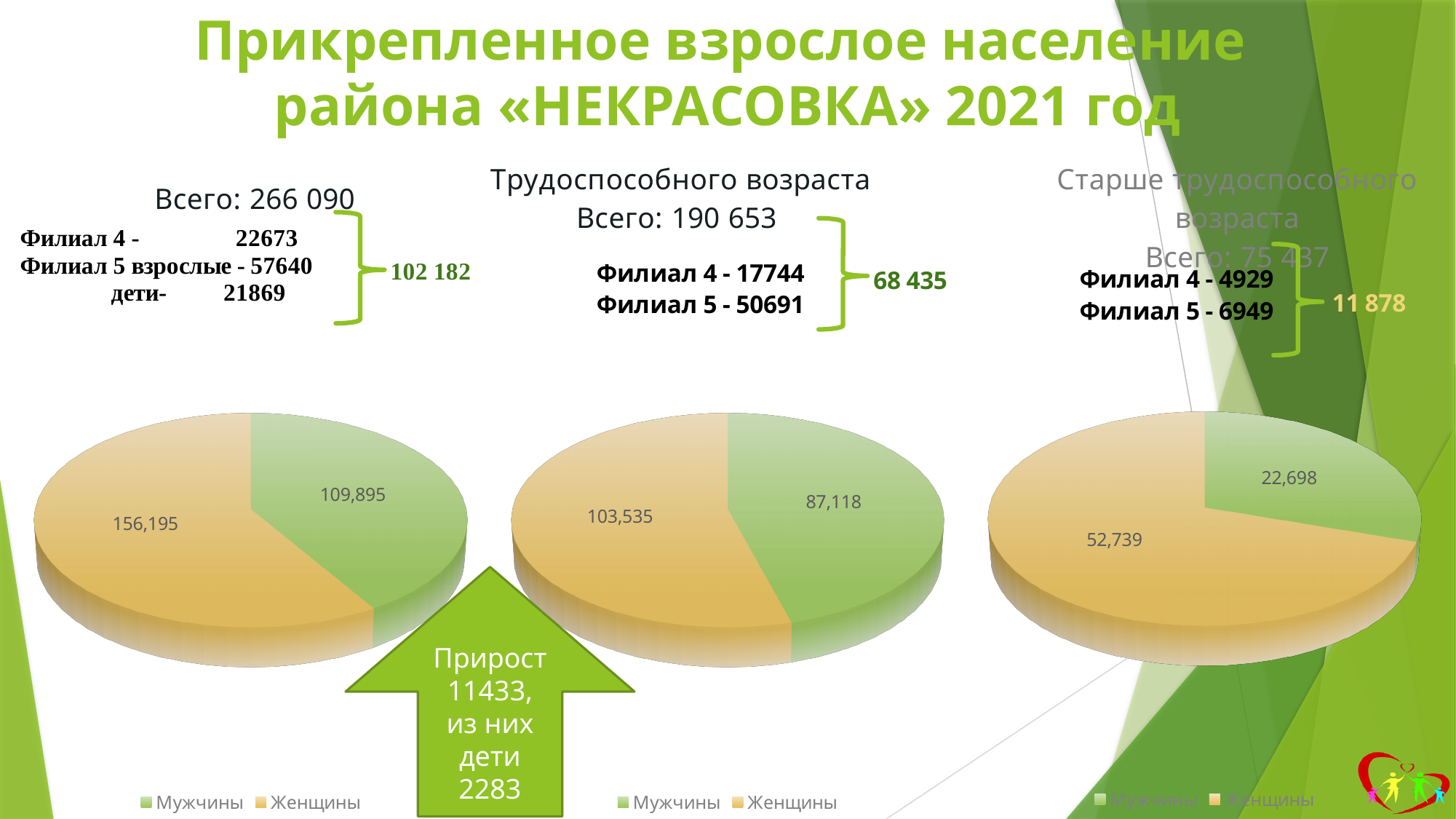
In the right pie chart, what is the value for Женщины? 52,739 In the right pie chart, which slice is larger, Мужчины or Женщины? Женщины In the left pie chart, what is the value for Женщины? 156,195 How many pie charts are shown on the slide? 3 In the middle pie chart, what is the difference between the Женщины and Мужчины values? 16,417 In the right pie chart, what is the value for Мужчины? 22,698 In the middle pie chart, what is the value for Мужчины? 87,118 How many series does the legend of the left pie chart list? 2 In the left pie chart, what is the value for Мужчины? 109,895 In the middle pie chart, what is the value for Женщины? 103,535 In the left pie chart, what is the difference between the Женщины and Мужчины values? 46,300 What kind of chart is the middle chart on the slide? Pie chart